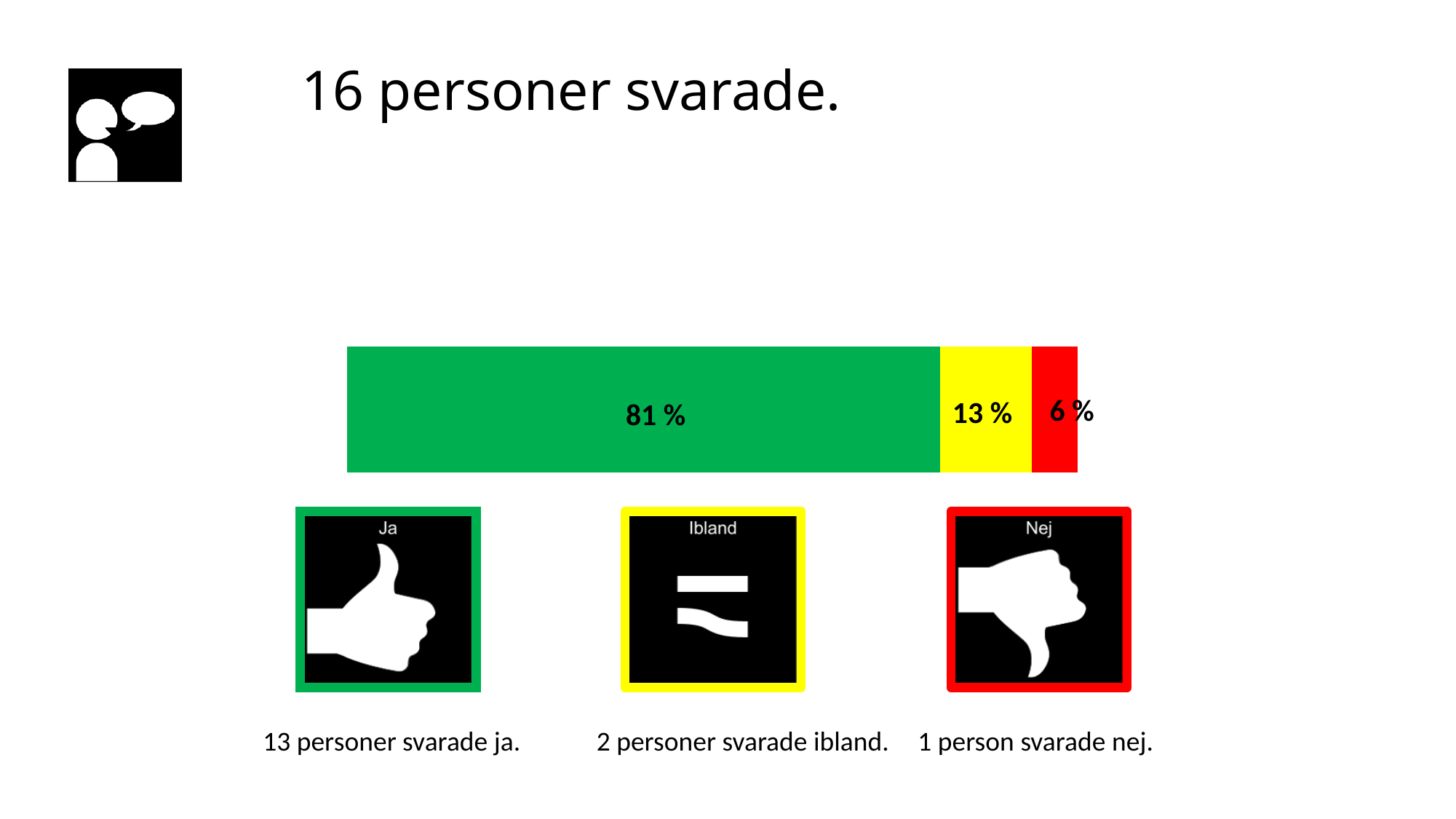
What kind of chart is shown on the slide? A stacked bar chart Which colour is used for the segment labelled 81 %? Green What is the difference in percentage points between the yellow segment and the red segment? 7 What is the total of the three percentages shown on the bar? 100 % Which segment of the bar has the smallest percentage? 6 % (red, Nej) What is the difference in percentage points between the green segment and the yellow segment? 68 What percentage is shown on the yellow segment of the bar? 13 % What percentage is shown on the green segment of the bar? 81 % How many segments does the bar have? 3 Which is larger, the yellow segment or the red segment? The yellow segment What percentage is shown on the red segment of the bar? 6 % Which segment of the bar has the largest percentage? 81 % (green, Ja)